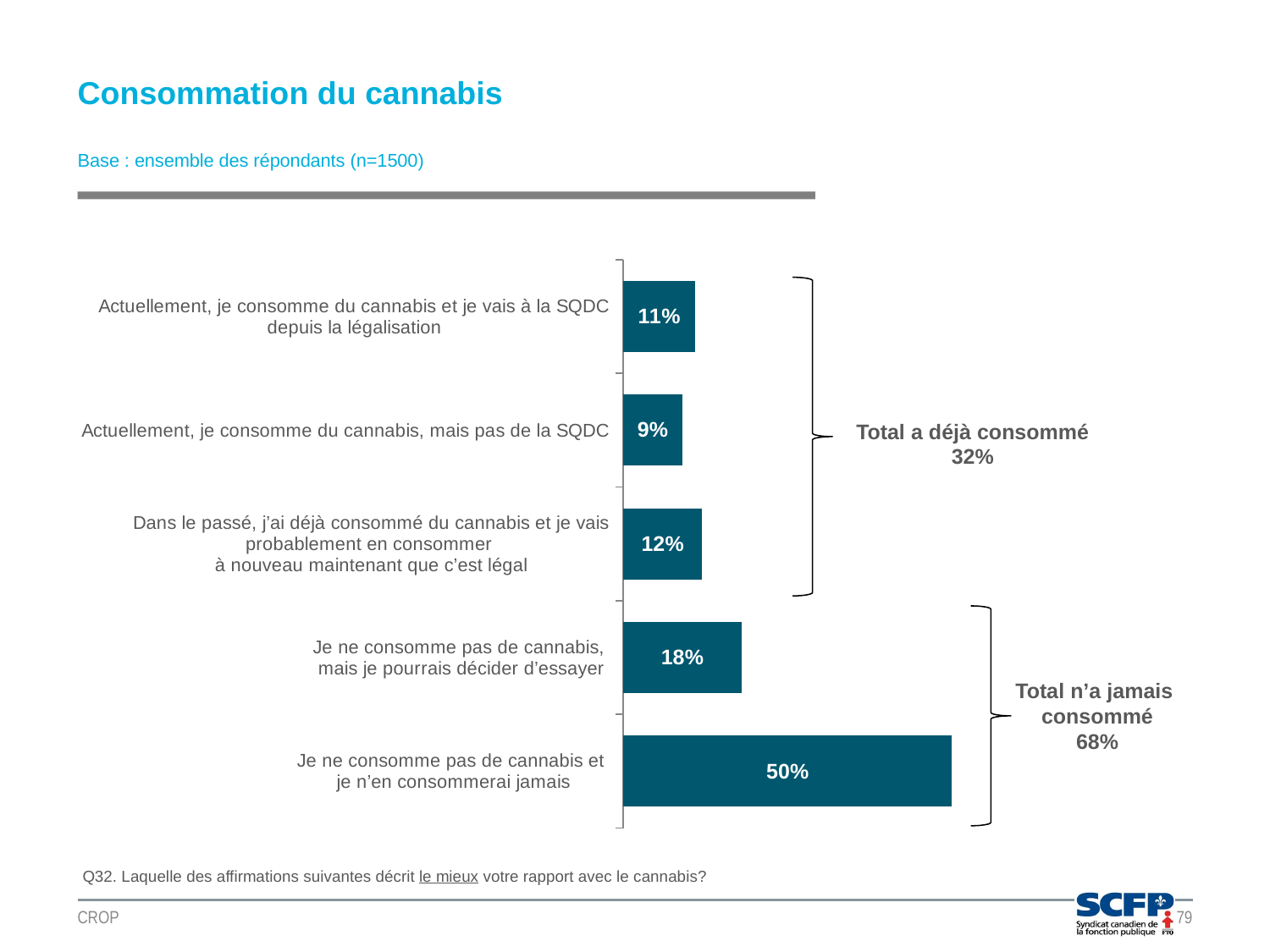
What percentage currently consume cannabis and go to the SQDC since legalisation? 11% What is the difference between the value for "Je ne consomme pas de cannabis et je n'en consommerai jamais" and the value for "Je ne consomme pas de cannabis, mais je pourrais décider d'essayer"? 32% What is the total shown for "Total n'a jamais consommé"? 68% What percentage of respondents say they do not consume cannabis and never will ("Je ne consomme pas de cannabis et je n'en consommerai jamais")? 50% How many categories are shown in the chart? 5 Which is larger: the value for "Dans le passé, j'ai déjà consommé du cannabis..." or the value for "Actuellement, je consomme du cannabis et je vais à la SQDC..."? Dans le passé, j'ai déjà consommé du cannabis... What kind of chart is shown on the slide? Bar chart What is the value for "Je ne consomme pas de cannabis, mais je pourrais décider d'essayer"? 18% Which category has the lowest value? Actuellement, je consomme du cannabis, mais pas de la SQDC Which category has the highest value? Je ne consomme pas de cannabis et je n'en consommerai jamais What is the total shown for "Total a déjà consommé"? 32% What is the value for "Actuellement, je consomme du cannabis, mais pas de la SQDC"? 9%